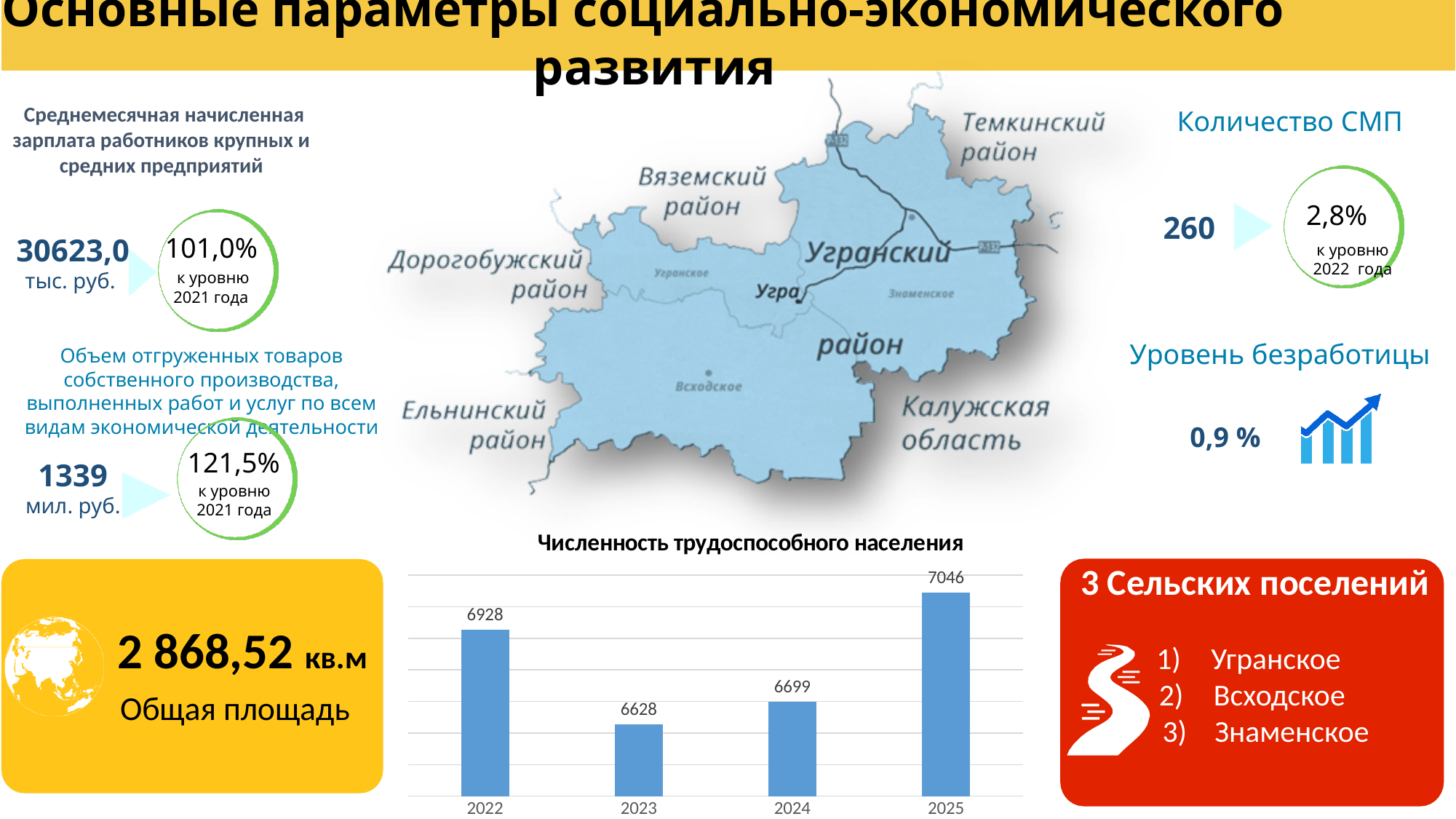
In the chart 'Численность трудоспособного населения', does the value rise or fall from 2023 to 2025? rise What is the value for 2022 in the chart 'Численность трудоспособного населения'? 6928 In the chart 'Численность трудоспособного населения', which is larger: the value for 2022 or the value for 2024? 2022 What is the value for 2024 in the chart 'Численность трудоспособного населения'? 6699 What is the value for 2025 in the chart 'Численность трудоспособного населения'? 7046 What is the value for 2023 in the chart 'Численность трудоспособного населения'? 6628 In the chart 'Численность трудоспособного населения', what is the difference between the values for 2024 and 2023? 71 What kind of chart is 'Численность трудоспособного населения'? bar chart In the chart 'Численность трудоспособного населения', what is the difference between the values for 2025 and 2022? 118 Which year has the lowest value in the chart 'Численность трудоспособного населения'? 2023 How many years are shown in the chart 'Численность трудоспособного населения'? 4 Which year has the highest value in the chart 'Численность трудоспособного населения'? 2025